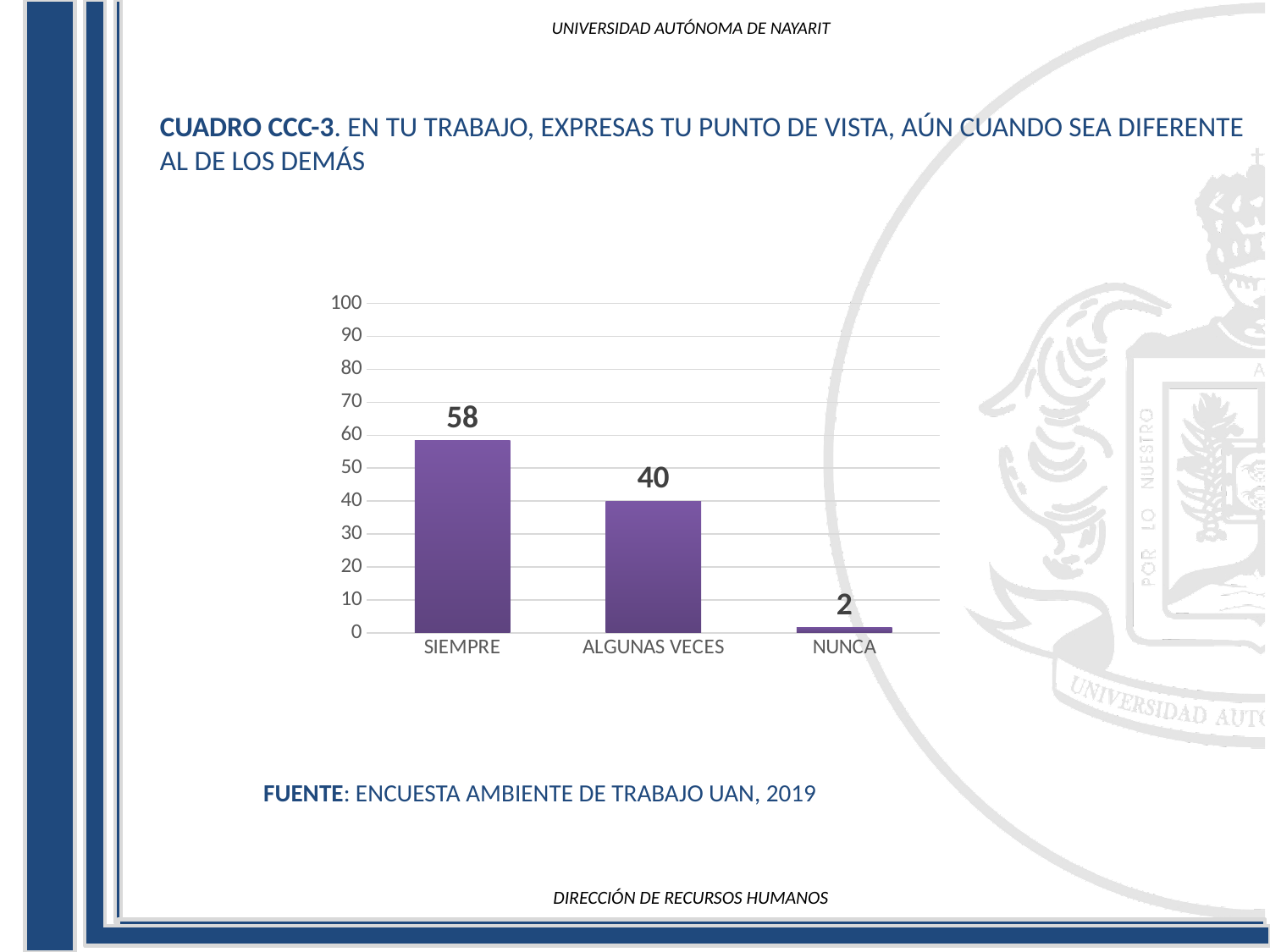
How many categories are shown on the x axis? 3 Is the value for SIEMPRE greater or less than 50? greater What is the value for ALGUNAS VECES? 40 Which category has the lowest value? NUNCA What is the value for NUNCA? 2 What is the difference between the values for SIEMPRE and ALGUNAS VECES? 18 Which category has the highest value? SIEMPRE What is the value for SIEMPRE? 58 Which is larger, the value for SIEMPRE or the value for ALGUNAS VECES? SIEMPRE What kind of chart is shown on the slide? bar chart What is the difference between the values for ALGUNAS VECES and NUNCA? 38 Do the values rise or fall from left to right along the x axis? fall